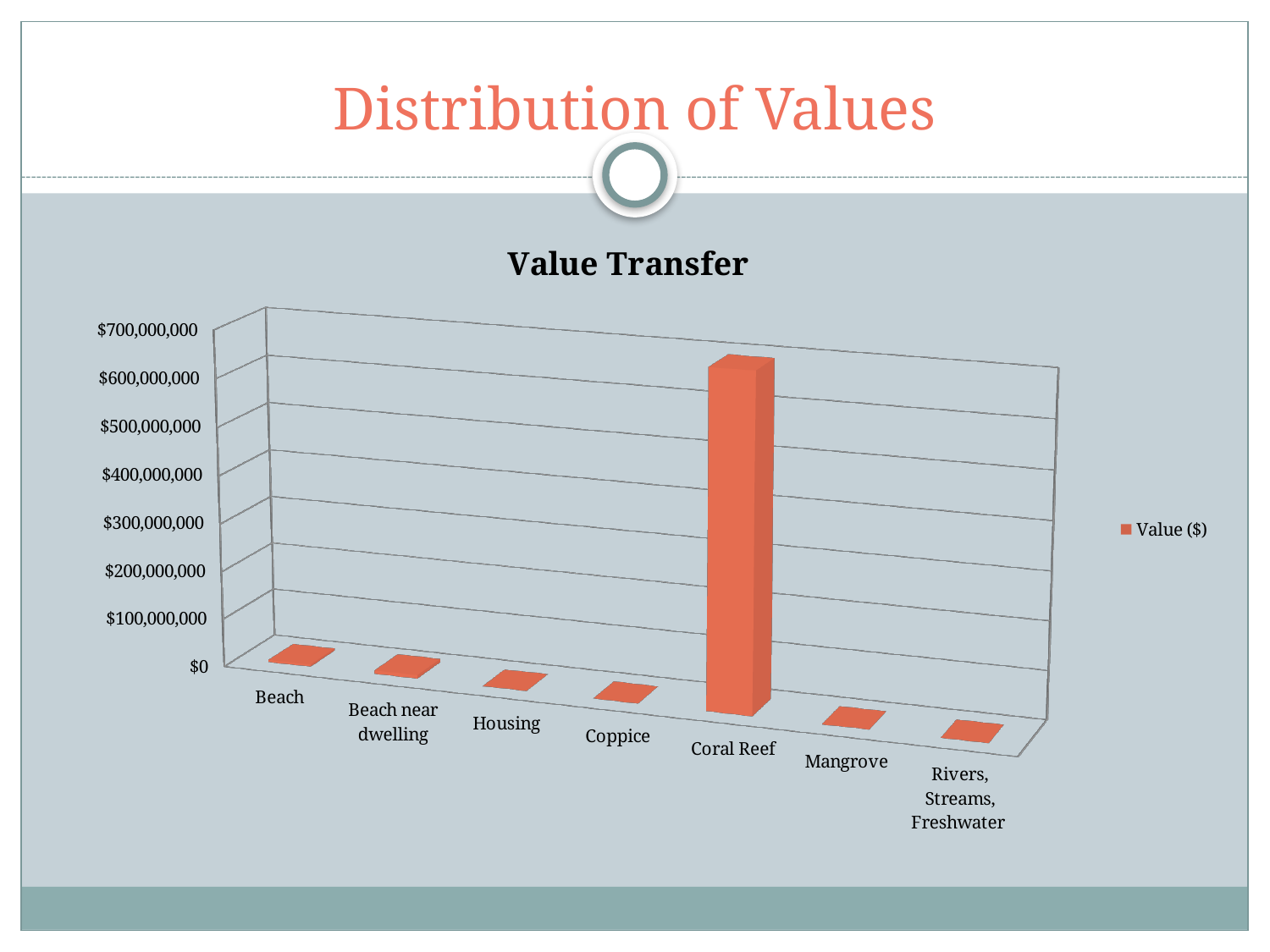
What is the name of the series shown in the legend? Value ($) Which category has the highest value? Coral Reef Is the value for Coral Reef greater or less than $700,000,000? less Which has a larger value, Coral Reef or Housing? Coral Reef How many series does the legend list? 1 What kind of chart is shown on the slide? Bar chart Which has a larger value, Coppice or Coral Reef? Coral Reef Is the value for Mangrove greater or less than $100,000,000? less How many categories are shown on the x axis of the chart? 7 Is the value for Beach greater or less than $100,000,000? less What is the title of the chart? Value Transfer